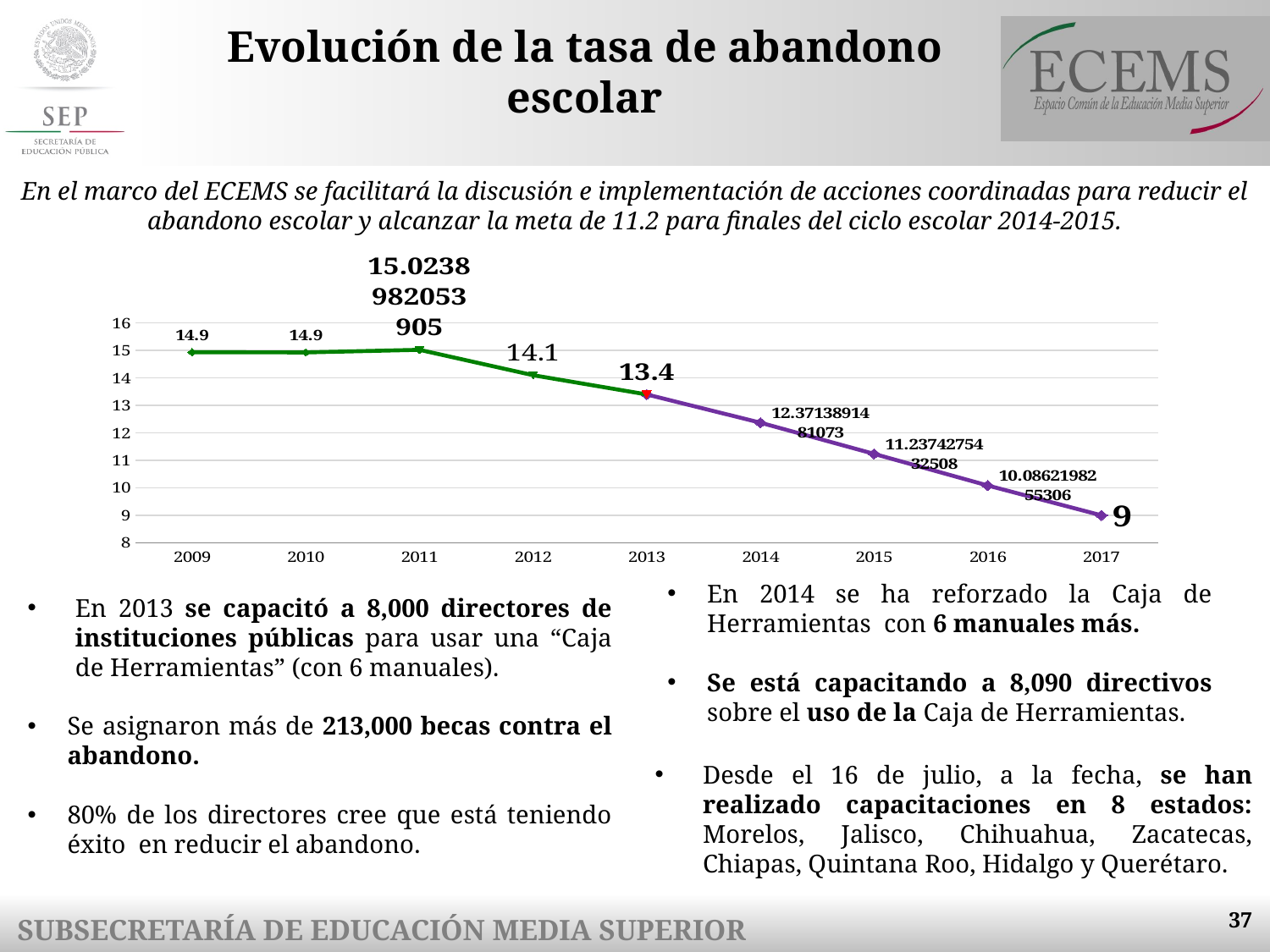
What is the value plotted for 2012? 14.1 What kind of chart is shown on the slide? line chart How many years are plotted on the x axis? 9 Do the values rise or fall from 2011 to 2017? fall What is the value plotted for 2017? 9 Is the value for 2015 greater or less than 12? less Which is larger, the value for 2013 or the value for 2014? 2013 Which year has the highest value on the chart? 2011 What is the value plotted for 2013? 13.4 What is the value plotted for 2009? 14.9 Which year has the lowest value on the chart? 2017 What is the difference between the values for 2012 and 2013? 0.7